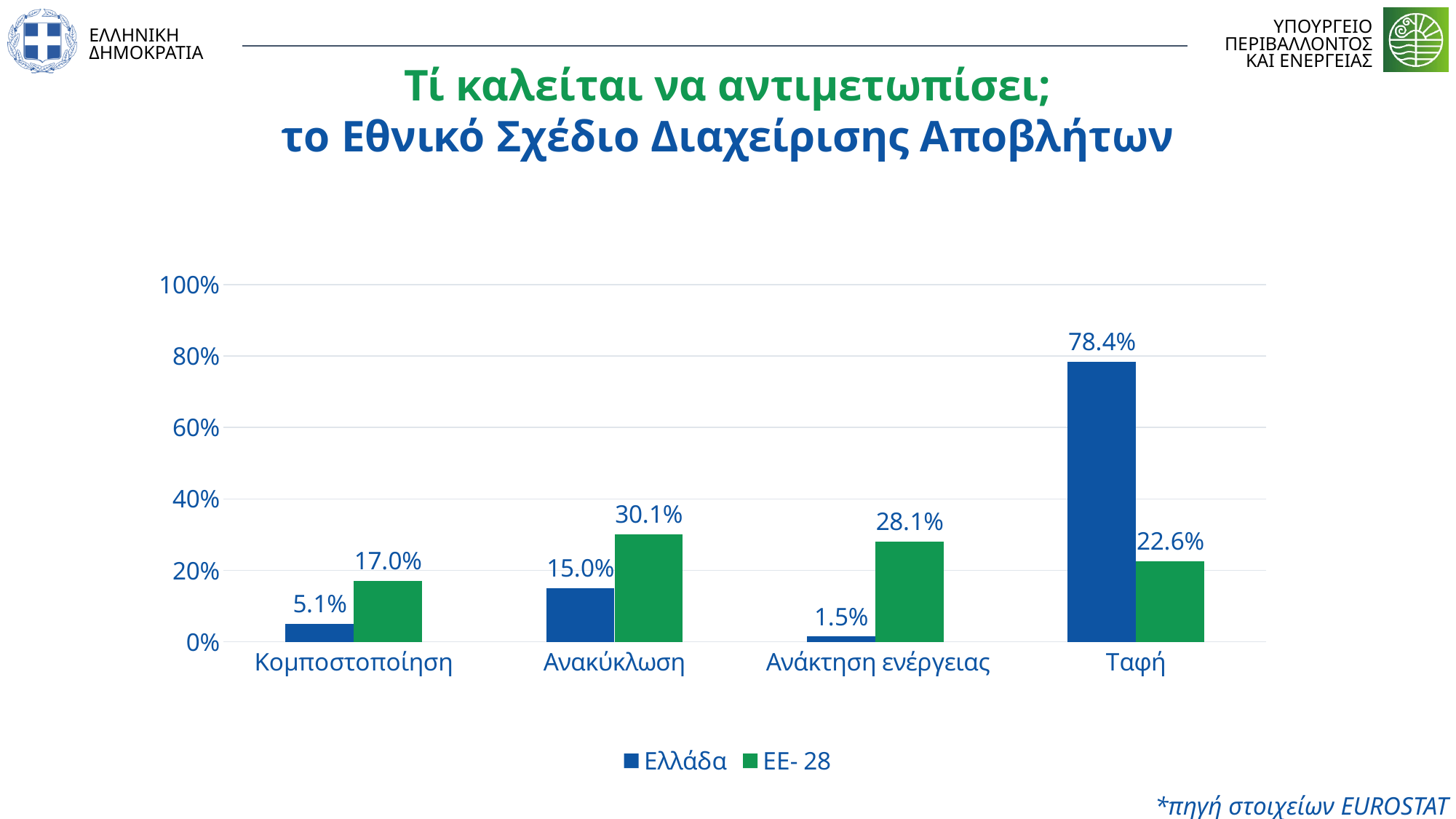
Which category has the highest value for Ελλάδα? Ταφή What is the difference between the Ελλάδα and ΕΕ-28 values for Ταφή? 55.8% What is the value for Ελλάδα in the Ανάκτηση ενέργειας category? 1.5% What is the value for ΕΕ-28 in the Ανακύκλωση category? 30.1% How many series does the legend list? 2 What kind of chart is shown on the slide? Bar chart How many categories are shown on the x axis? 4 Is the value for Ελλάδα in Ταφή greater or less than 60%? greater Which is larger for Ανακύκλωση: the Ελλάδα value or the ΕΕ-28 value? ΕΕ-28 Which category has the lowest value for ΕΕ-28? Κομποστοποίηση What is the value for Ελλάδα in the Ταφή category? 78.4% What is the value for ΕΕ-28 in the Κομποστοποίηση category? 17.0%